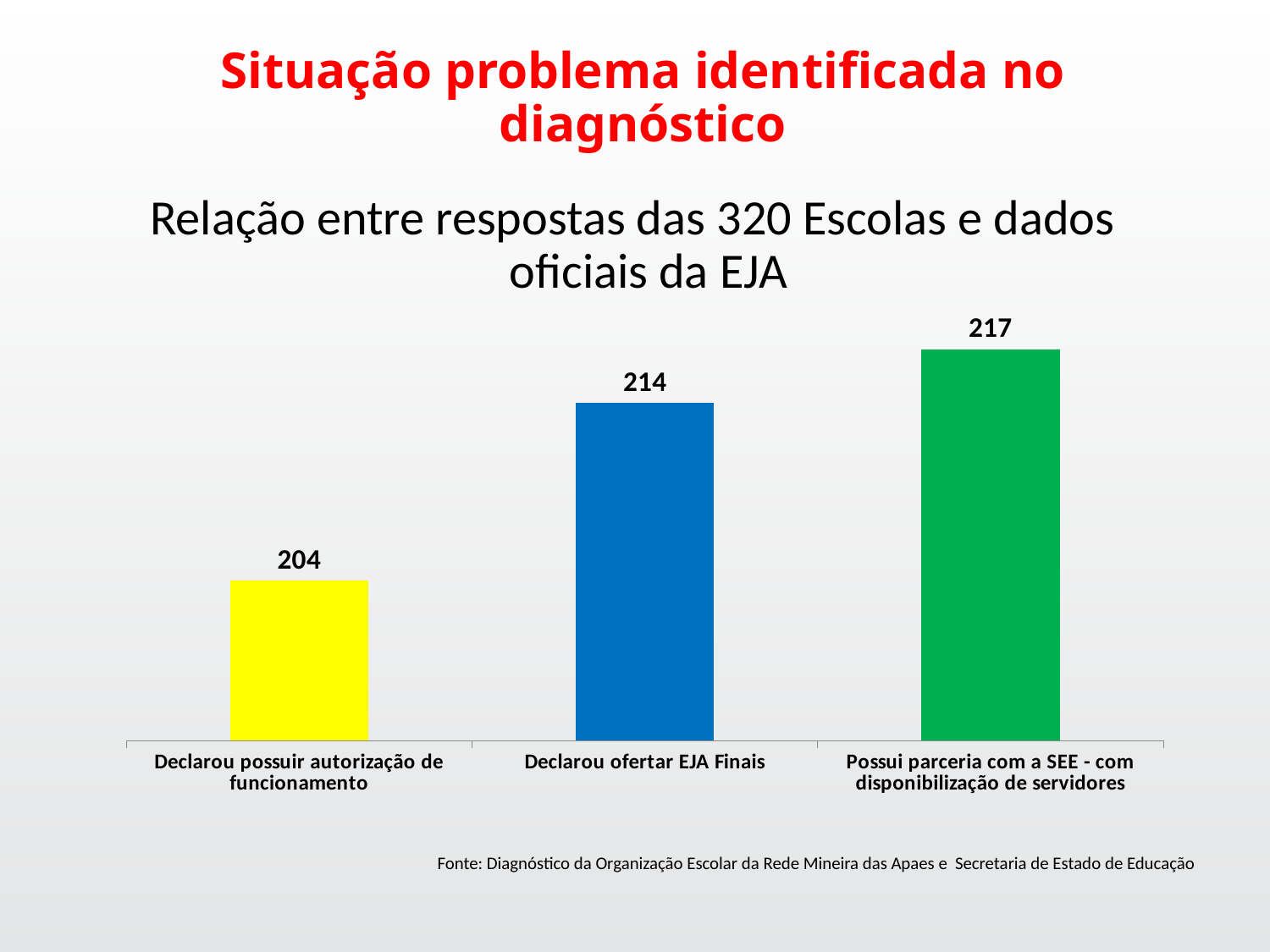
What colour is the bar for "Declarou ofertar EJA Finais"? Blue Do the values rise or fall from left to right across the categories? Rise What is the value for "Declarou possuir autorização de funcionamento"? 204 What is the value for "Possui parceria com a SEE - com disponibilização de servidores"? 217 Which category has the lowest value? Declarou possuir autorização de funcionamento How many categories are shown in the chart? 3 What is the difference between the values for "Possui parceria com a SEE - com disponibilização de servidores" and "Declarou possuir autorização de funcionamento"? 13 What kind of chart is shown on the slide? Bar chart Which category has the highest value? Possui parceria com a SEE - com disponibilização de servidores What is the difference between the values for "Declarou ofertar EJA Finais" and "Declarou possuir autorização de funcionamento"? 10 Which is larger: the value for "Declarou ofertar EJA Finais" or for "Declarou possuir autorização de funcionamento"? Declarou ofertar EJA Finais What is the value for "Declarou ofertar EJA Finais"? 214